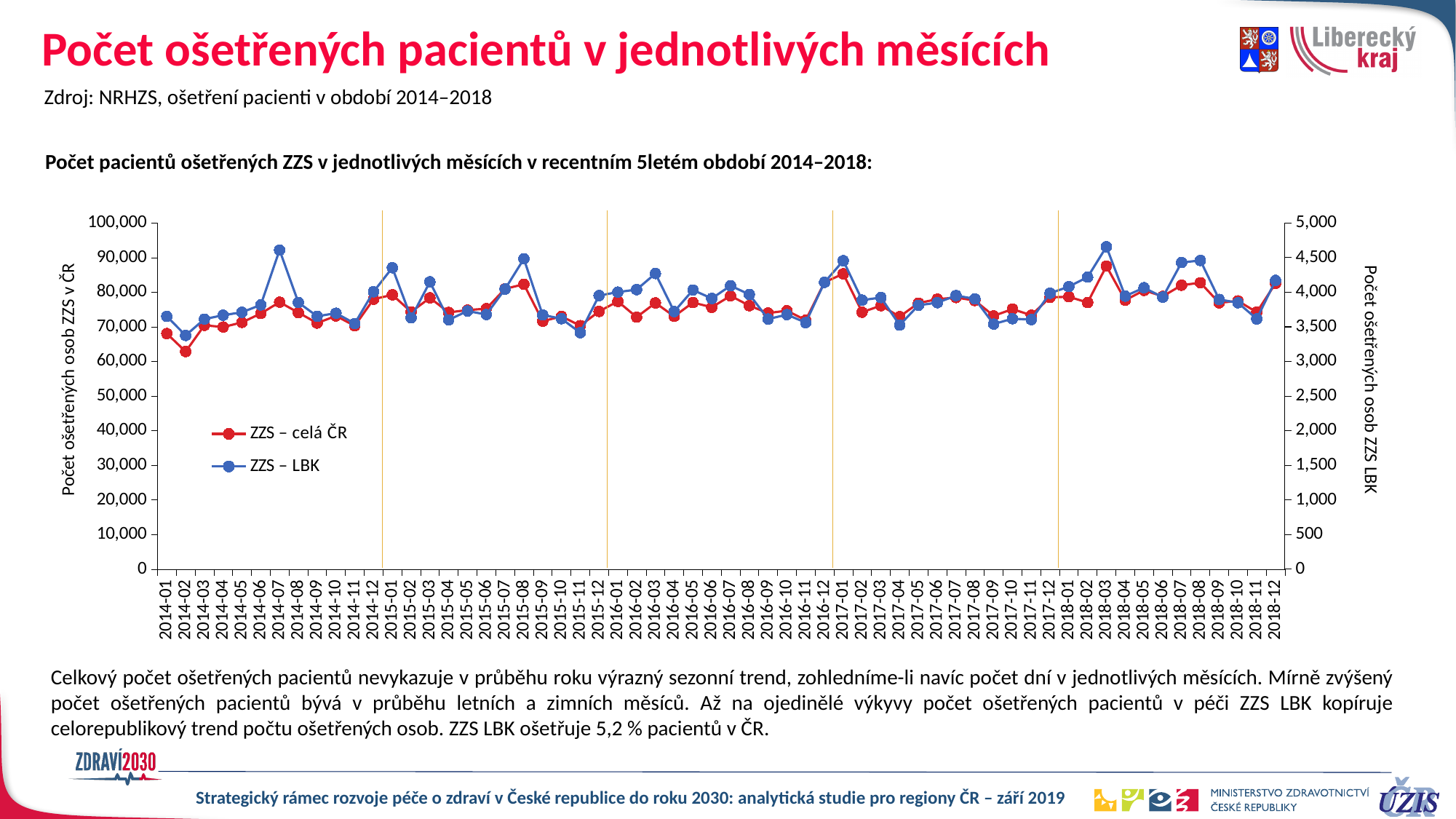
Is the value for ZZS – LBK in 2014-07 greater or less than 4,000? greater What is the first month shown on the x axis? 2014-01 How many series does the chart's legend list? 2 What are the two series named in the legend? ZZS – celá ČR and ZZS – LBK Which month has the lowest value for the ZZS – celá ČR series? 2014-02 Which is larger for the ZZS – celá ČR series: the value in 2014-02 or the value in 2014-07? 2014-07 How many monthly data points are plotted along the x axis? 60 What colour is the line for the ZZS – LBK series? blue Is the value for ZZS – LBK in 2018-03 greater or less than 4,000? greater Is the value for ZZS – celá ČR in 2017-01 greater or less than 80,000? greater What kind of chart is shown on the slide? line chart